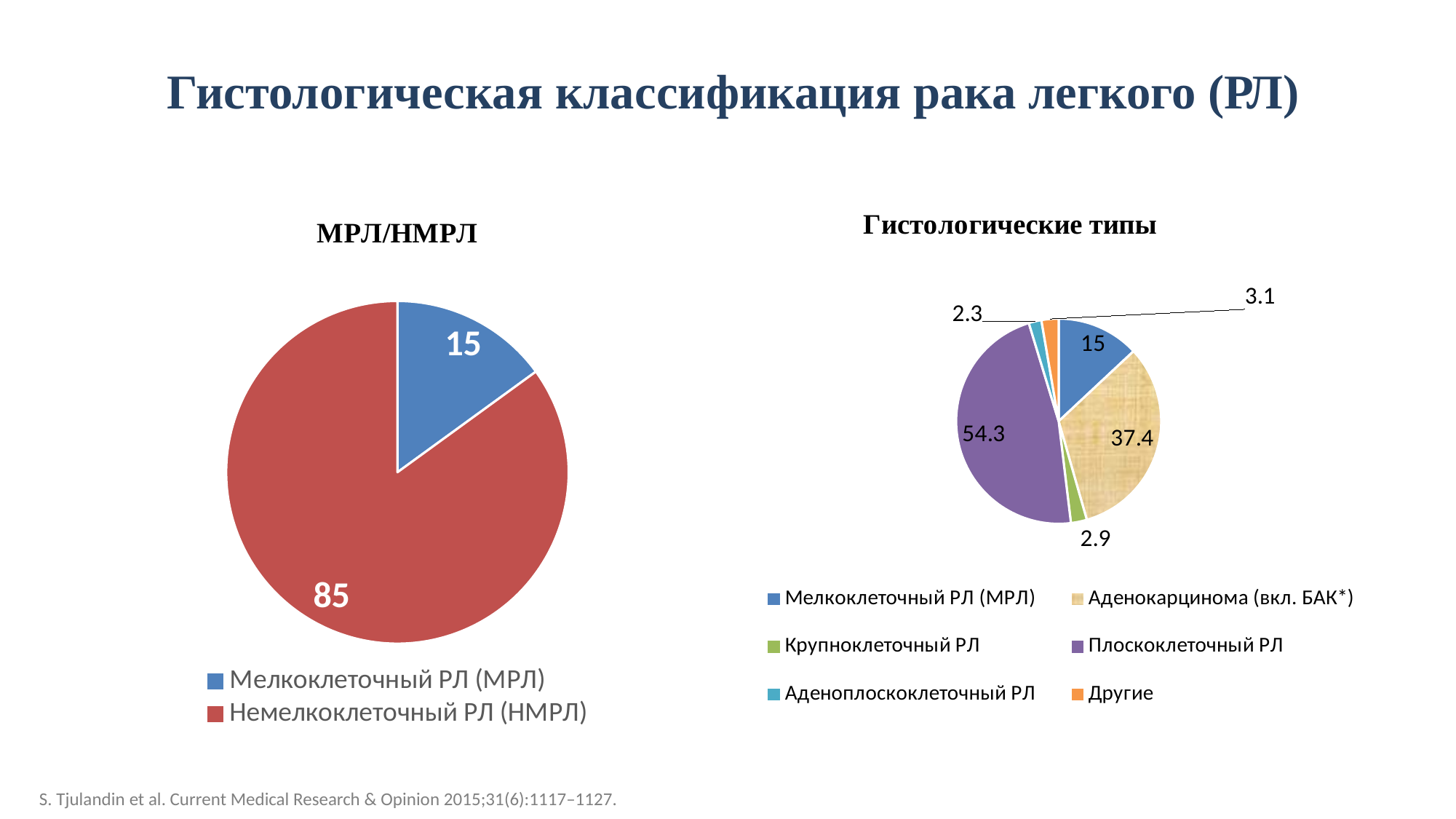
What kind of chart is the МРЛ/НМРЛ chart? Pie chart In the Гистологические типы chart, what is the value for Аденокарцинома (вкл. БАК*)? 37.4 In the Гистологические типы chart, which is larger: the value for Другие or the value for Аденоплоскоклеточный РЛ? Другие In the МРЛ/НМРЛ chart, what is the value for Мелкоклеточный РЛ (МРЛ)? 15 In the Гистологические типы chart, what is the value for Крупноклеточный РЛ? 2.9 In the Гистологические типы chart, what is the value for Плоскоклеточный РЛ? 54.3 In the Гистологические типы chart, which category has the lowest value? Аденоплоскоклеточный РЛ In the МРЛ/НМРЛ chart, what is the difference between the values for НМРЛ and МРЛ? 70 In the Гистологические типы chart, how many categories does the legend list? 6 How many series does the legend of the МРЛ/НМРЛ chart list? 2 In the Гистологические типы chart, which category has the highest value? Плоскоклеточный РЛ In the МРЛ/НМРЛ chart, what is the value for Немелкоклеточный РЛ (НМРЛ)? 85